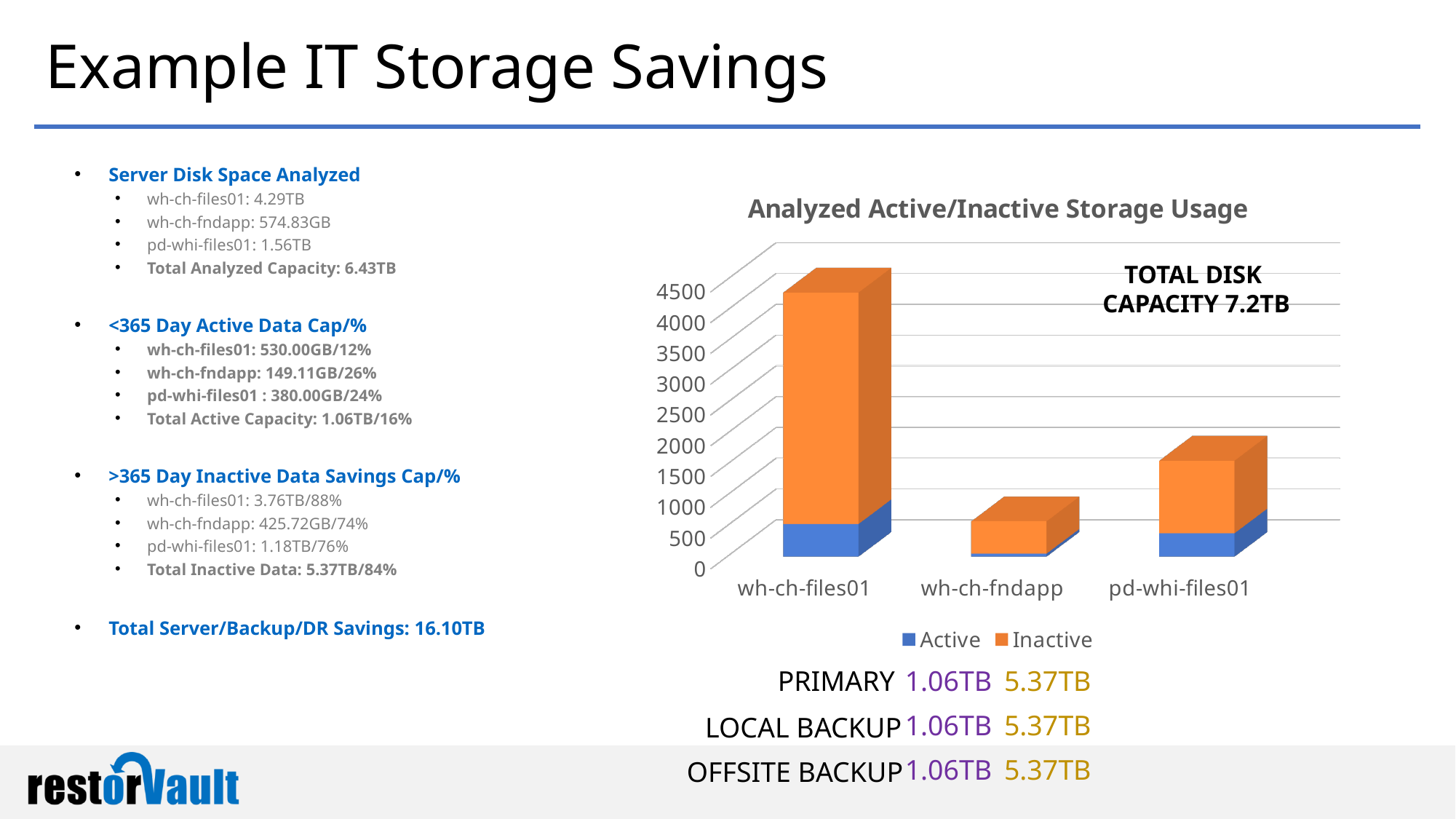
Which server has the shortest stacked bar in the chart? wh-ch-fndapp How many series does the chart legend list? 2 What is the title of the chart? Analyzed Active/Inactive Storage Usage What total disk capacity is annotated on the chart? 7.2TB How many servers (categories) are shown on the x axis of the chart? 3 What kind of chart is shown on the slide? Stacked bar chart Is the total stacked bar for pd-whi-files01 greater or less than 1000? greater Which server has the tallest stacked bar in the chart? wh-ch-files01 Is the total stacked bar for wh-ch-fndapp greater or less than 1000? less Which stacked bar is taller, pd-whi-files01 or wh-ch-fndapp? pd-whi-files01 Is the total stacked bar for wh-ch-files01 greater or less than 3500? greater